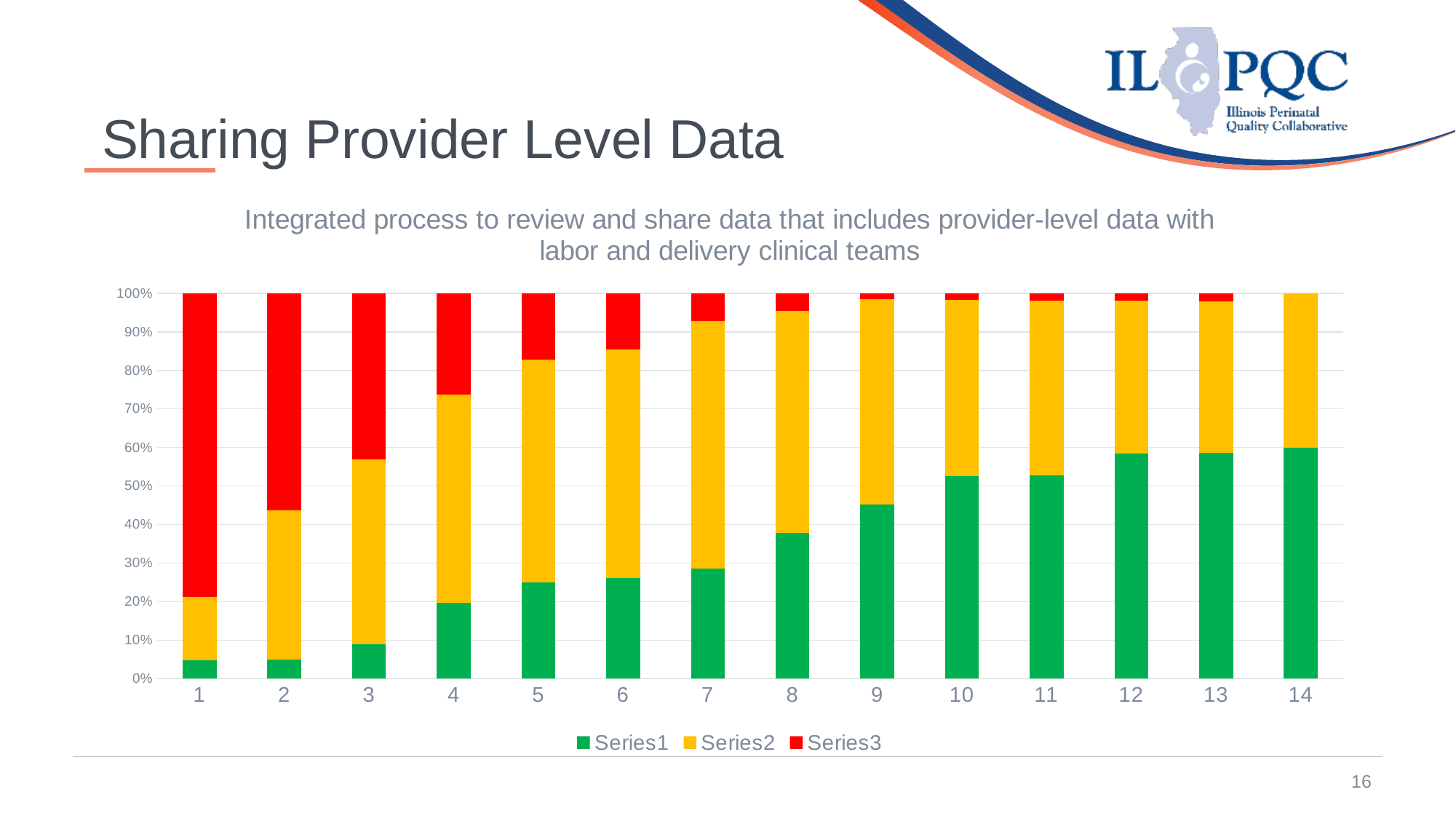
What is the title shown above the chart? Integrated process to review and share data that includes provider-level data with labor and delivery clinical teams Is the Series1 (green) value for category 9 greater or less than 40%? greater Is the Series1 (green) value for category 8 greater or less than 30%? greater Is the Series3 (red) segment for category 1 greater or less than 70% of the bar? greater Which category has the largest Series3 (red) segment? 1 How many series does the chart legend list? 3 Which has the larger Series1 (green) segment, category 10 or category 5? 10 Does the Series1 (green) segment generally rise or fall from category 1 to category 14? rise What is the total height of each stacked bar, as shown on the y axis? 100% What kind of chart is shown on the slide? stacked bar chart Which category has no visible Series3 (red) segment at all? 14 How many categories are shown on the x axis of the chart? 14